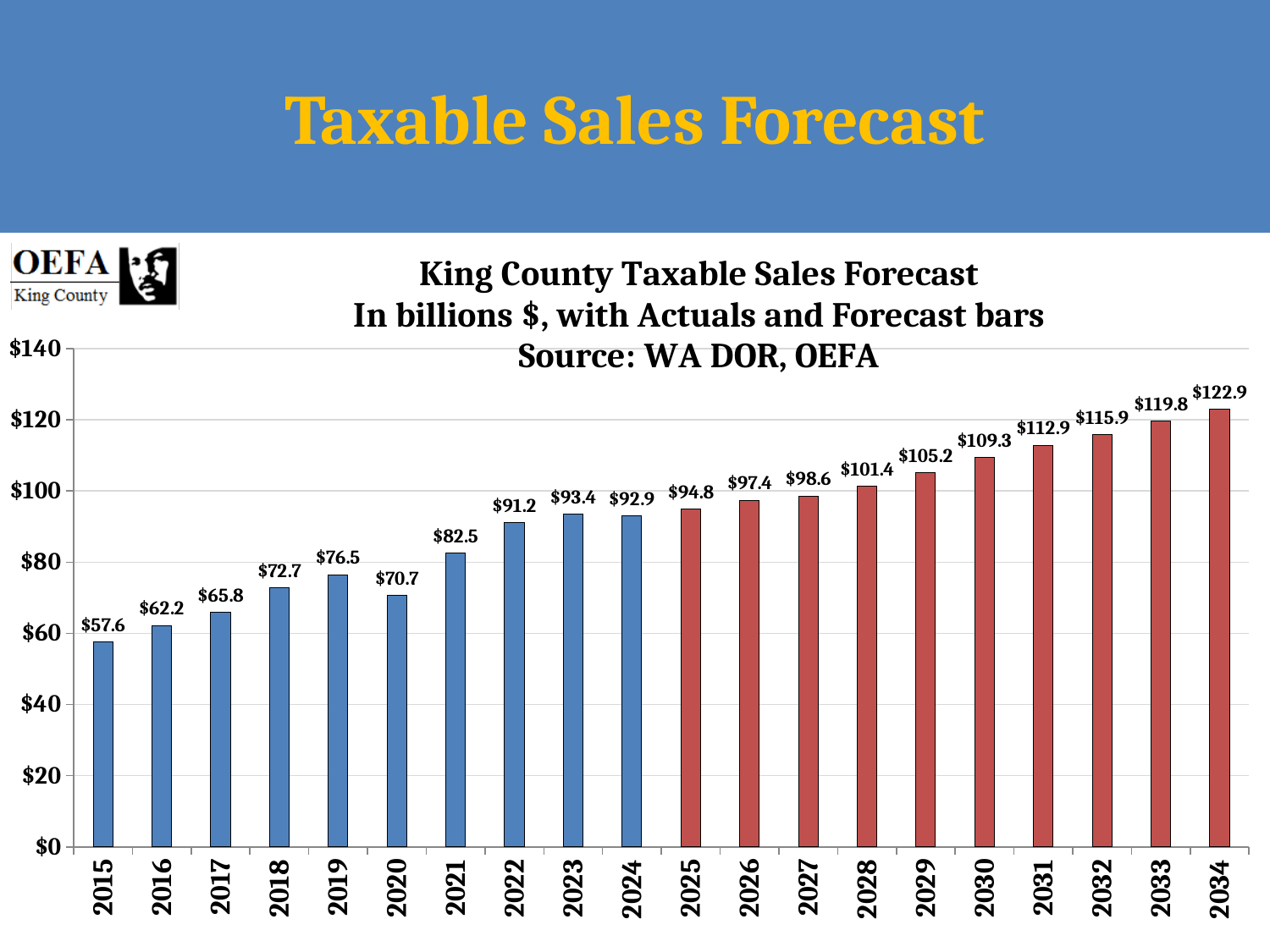
Do the values generally rise or fall from 2025 to 2034? Rise What is the difference between the 2034 value and the 2015 value? $65.3 How many years are shown on the x axis? 20 What is the taxable sales value for 2028? $101.4 What kind of chart is shown? Bar chart Which year has the highest taxable sales value? 2034 Which is larger, the value for 2023 or the value for 2024? 2023 Which year has the lowest taxable sales value? 2015 Is the value for 2031 greater or less than $100? greater What is the taxable sales value for 2020? $70.7 What colour are the forecast bars from 2025 onward? Red What is the difference between the 2020 value and the 2019 value? $5.8